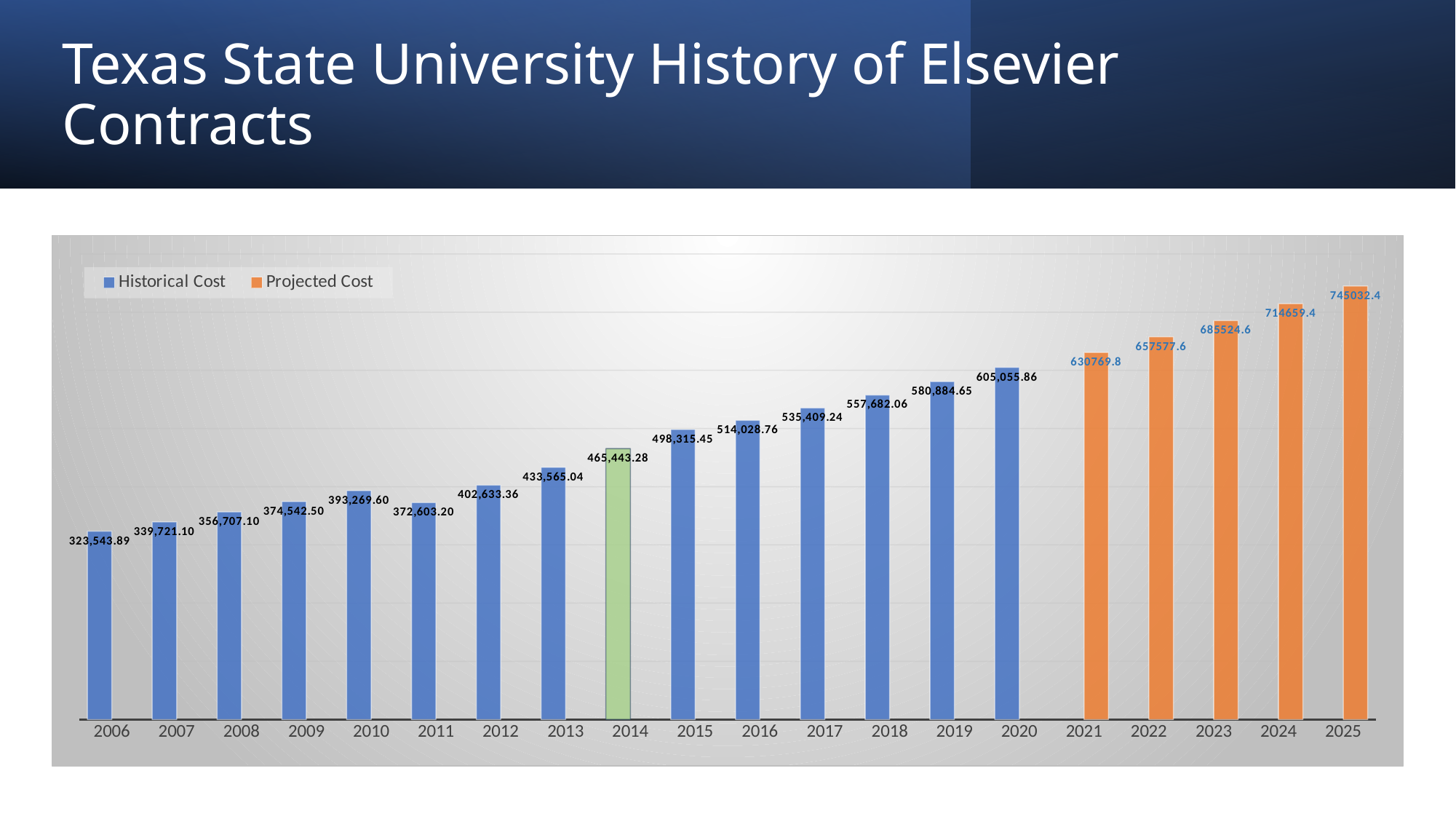
Which year has the highest cost shown on the chart? 2025 How many series does the legend list? 2 What kind of chart is shown on the slide? Bar chart What is the Historical Cost for 2020? 605,055.86 Which is larger, the Historical Cost for 2010 or for 2011? 2010 What is the difference between the Historical Cost for 2020 and for 2006? 281,511.97 What is the Projected Cost for 2021? 630769.8 What is the Projected Cost for 2025? 745032.4 What is the Historical Cost for 2014? 465,443.28 How many years are shown on the x axis of the chart? 20 What is the difference between the Historical Cost for 2010 and for 2011? 20,666.40 Which year has the lowest cost shown on the chart? 2006